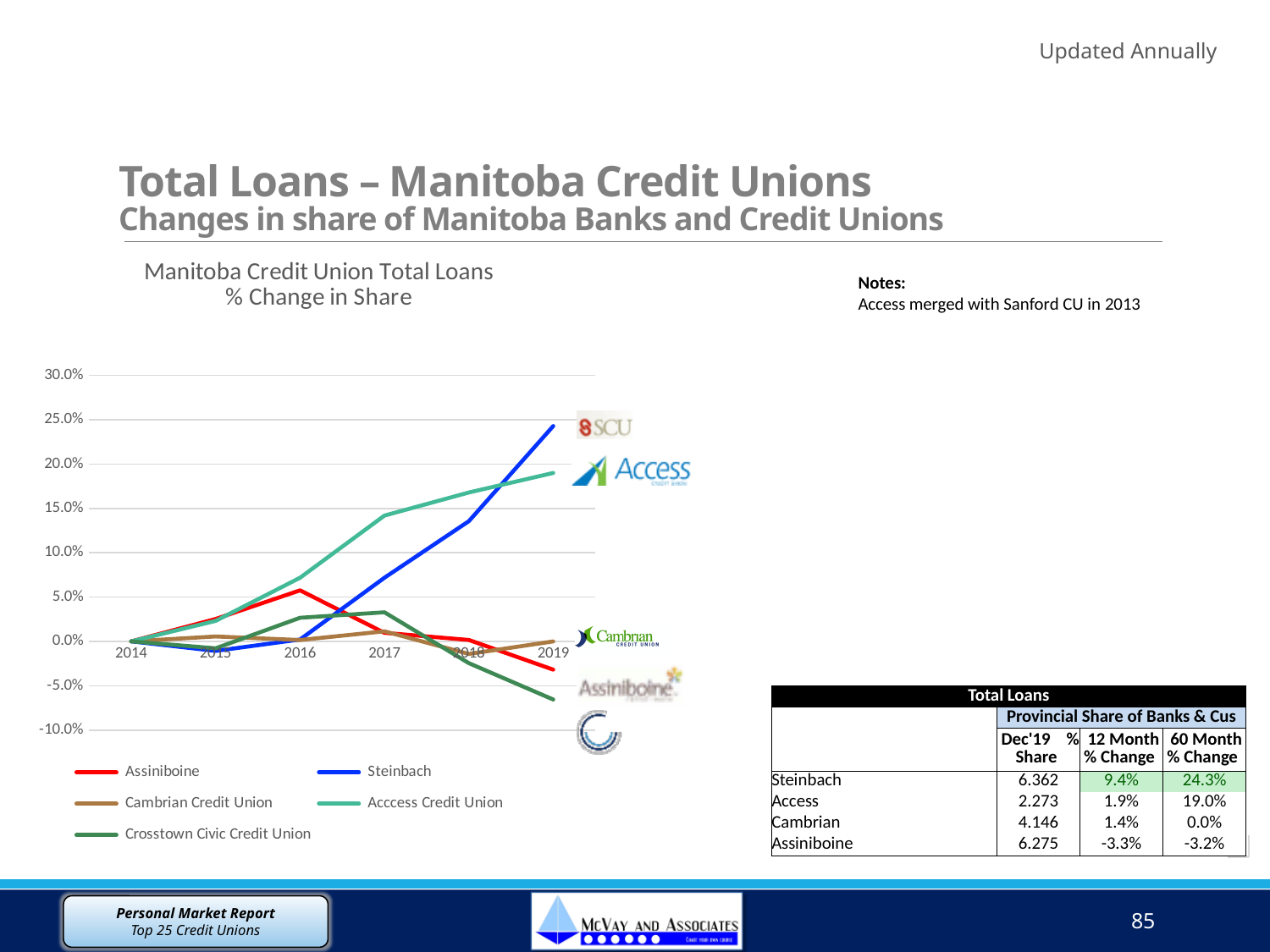
Is the value for Steinbach in 2019 greater or less than 20.0%? greater Which series has the lowest value in 2019? Crosstown Civic Credit Union Is the value for Crosstown Civic Credit Union in 2019 greater or less than -5.0%? less In 2017, which is larger: the value for Acccess Credit Union or the value for Steinbach? Acccess Credit Union How many series does the chart legend list? 5 What is the title of the chart? Manitoba Credit Union Total Loans % Change in Share Does the Steinbach line rise or fall between 2016 and 2019? rise Is the value for Acccess Credit Union in 2017 greater or less than 10.0%? greater What type of chart is shown on the slide? line chart In 2019, which is larger: the value for Steinbach or the value for Assiniboine? Steinbach Which series has the highest value in 2019? Steinbach How many years are shown on the x axis of the chart? 6